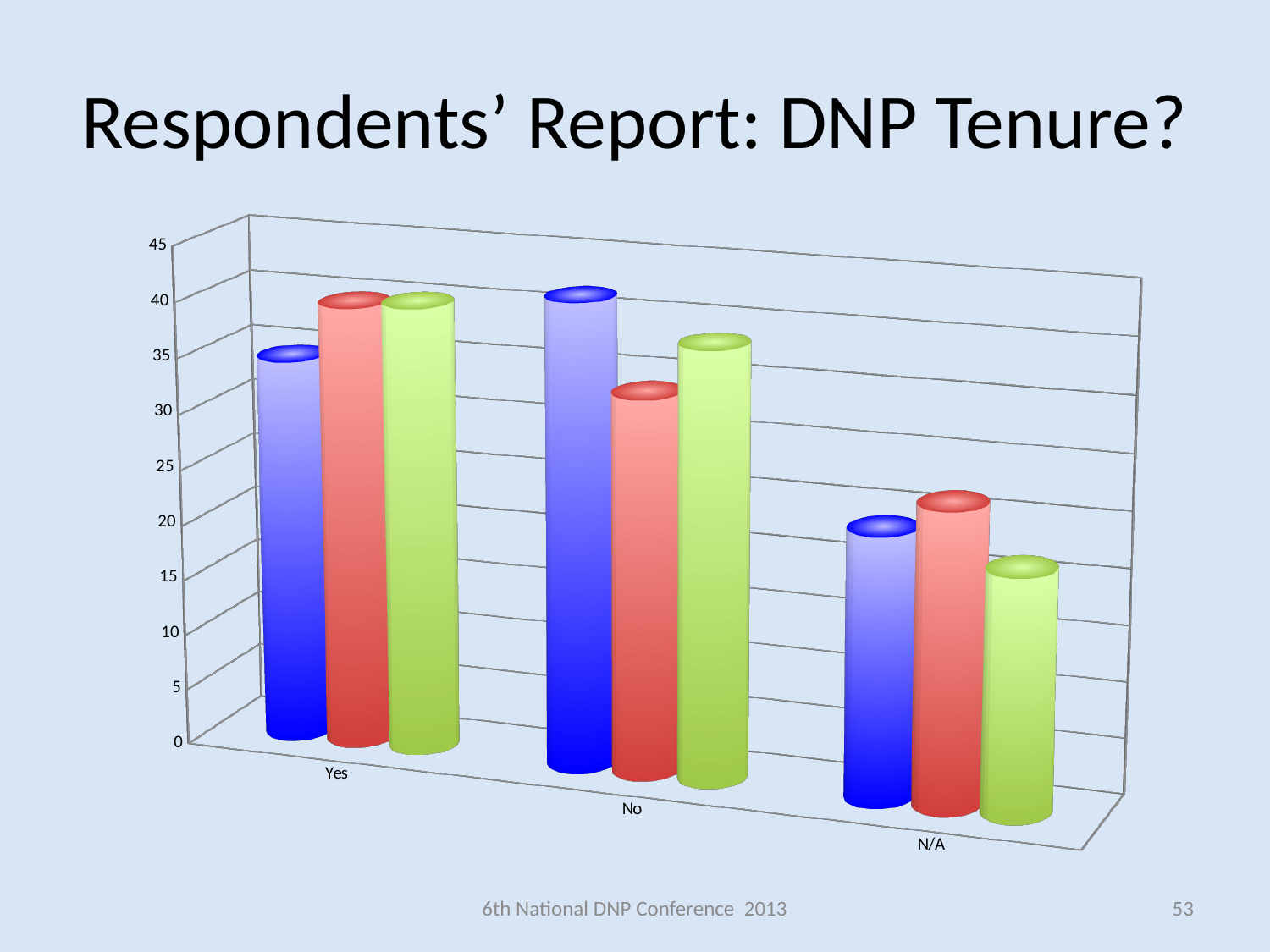
Is the value of the green bar for Yes greater or less than 30? greater What is the title of the chart slide? Respondents' Report: DNP Tenure? Which is larger, the blue bar for No or the blue bar for N/A? No How many categories are shown on the x axis of the chart? 3 Which category has the lowest green bar? N/A Is the value of the red bar for No greater or less than 20? greater How many bars are plotted in the chart in total? 9 Is the value of the blue bar for N/A greater or less than 30? less Which is larger, the red bar for Yes or the red bar for No? Yes What kind of chart is shown on the slide? bar chart Which category has the highest blue bar? No